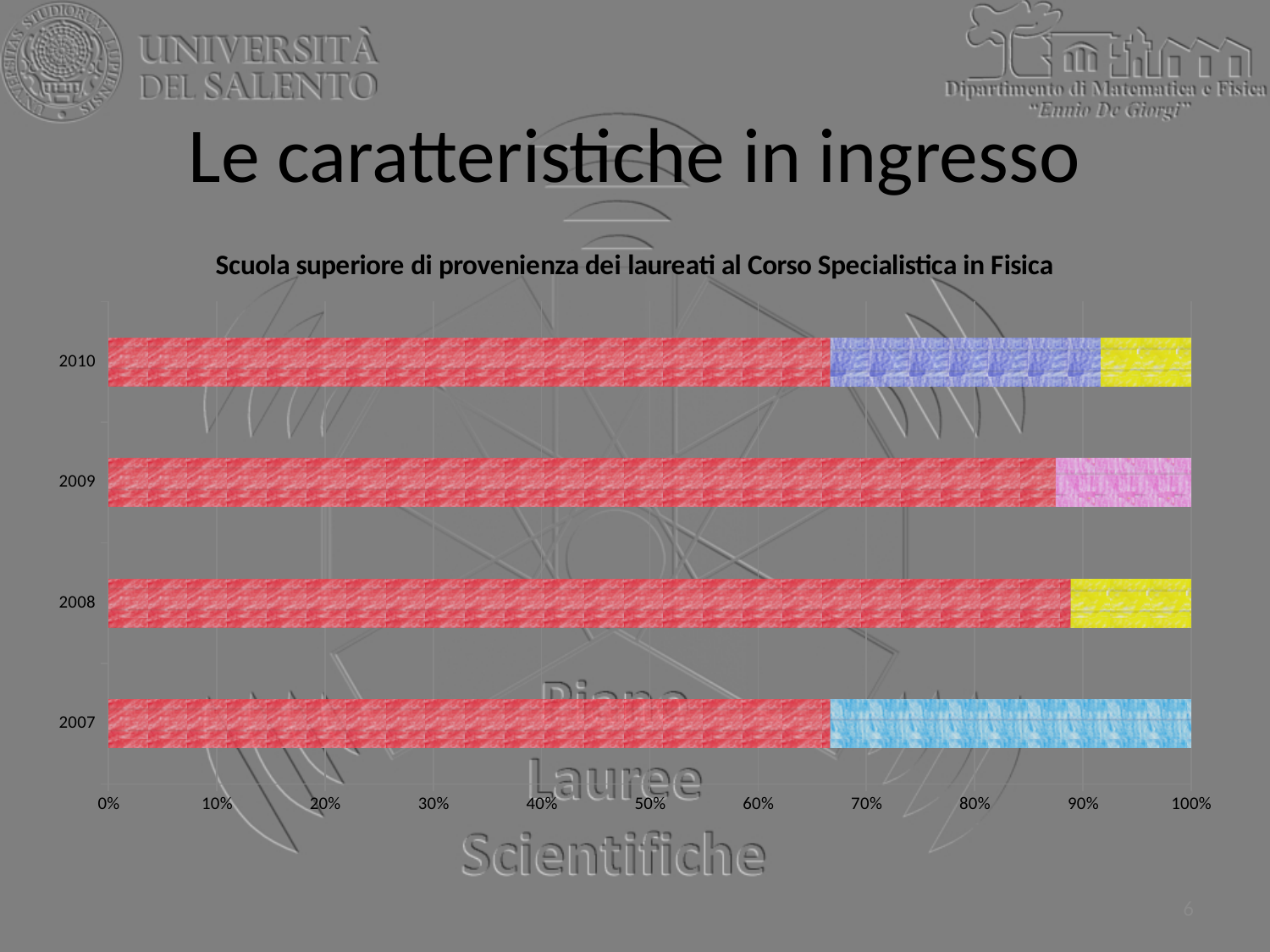
Is the red (first) segment of the 2010 bar greater or less than 60%? greater What kind of chart is shown on the slide? Stacked bar chart How many segments make up the 2010 bar? 3 Is the red (first) segment of the 2007 bar greater or less than 70%? less What total does each stacked bar reach on the horizontal axis? 100% Which year has the larger red (first) segment, 2009 or 2010? 2009 Which year has the larger red (first) segment, 2008 or 2007? 2008 How many years (categories) are plotted on the chart? 4 What is the title of the chart? Scuola superiore di provenienza dei laureati al Corso Specialistica in Fisica Is the red (first) segment of the 2010 bar greater or less than 70%? less Which years are shown on the vertical axis of the chart? 2007, 2008, 2009, 2010